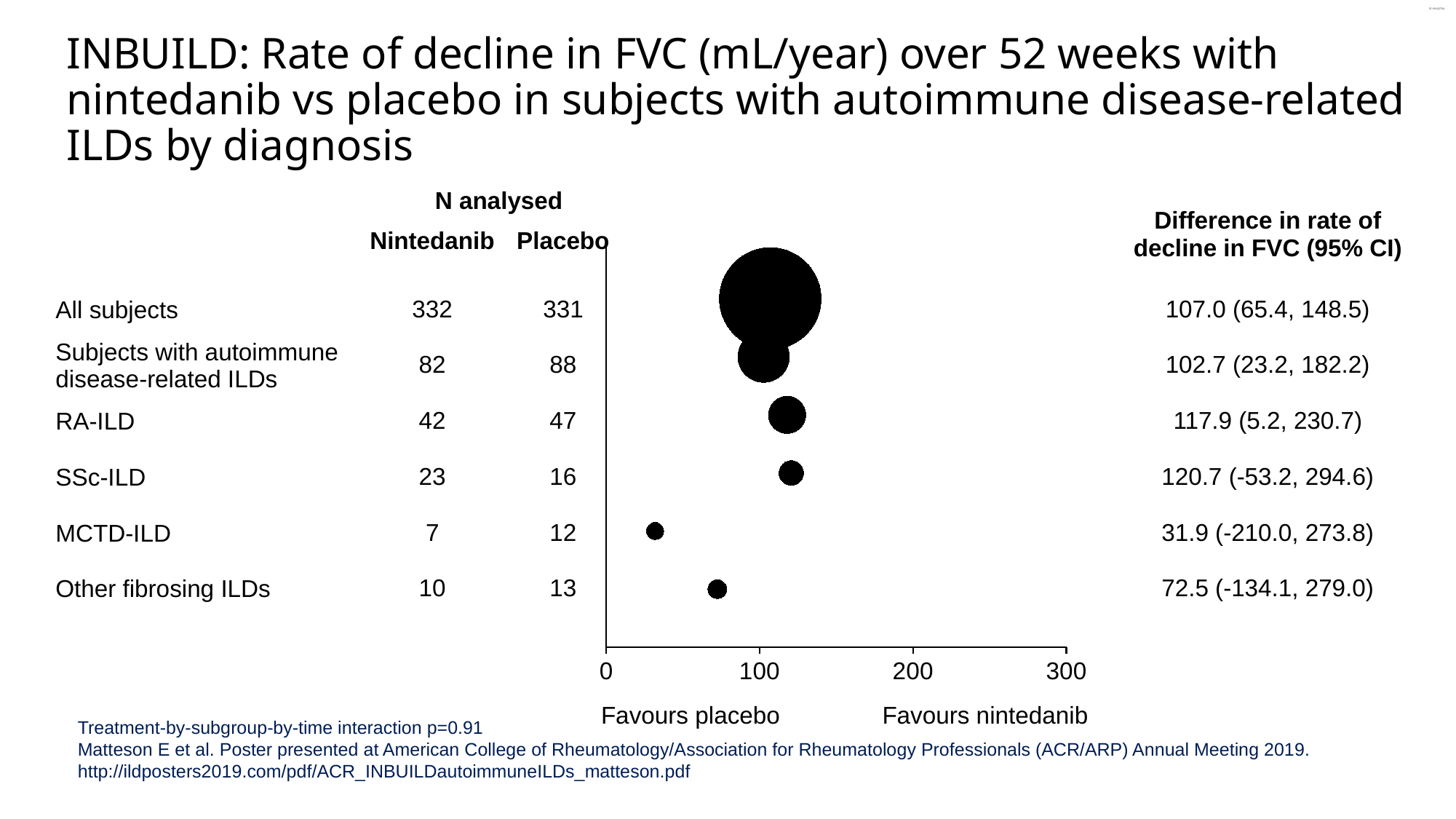
Is the point estimate for MCTD-ILD greater or less than 100? less What is the difference between the point estimates for RA-ILD and MCTD-ILD? 86.0 How many nintedanib subjects were analysed in the RA-ILD subgroup? 42 What is the difference in rate of decline in FVC for All subjects? 107.0 (65.4, 148.5) Which subgroup has the lowest point estimate for the difference in rate of decline in FVC? MCTD-ILD Which subgroup has the highest point estimate for the difference in rate of decline in FVC? SSc-ILD What kind of chart is shown on the slide? bubble chart (forest plot) What is the point estimate of the difference in rate of decline in FVC for MCTD-ILD? 31.9 How many subgroups (rows) are plotted in the chart? 6 Which has a larger point estimate for the difference in rate of decline in FVC: All subjects or Other fibrosing ILDs? All subjects What does the right side of the x axis favour according to the label below the chart? Favours nintedanib What is the 95% CI for the difference in rate of decline in FVC for RA-ILD? (5.2, 230.7)